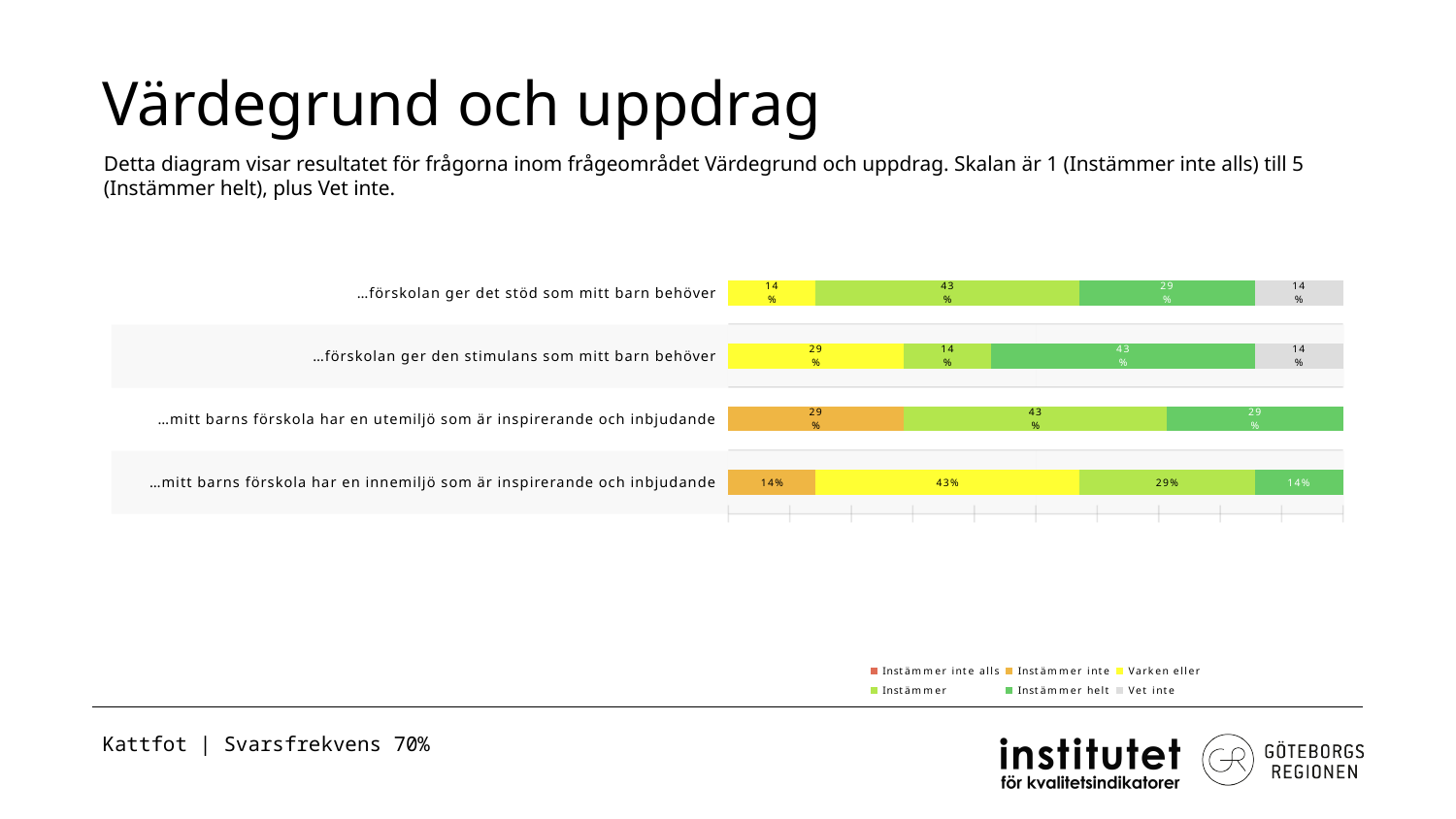
Which is larger for '…mitt barns förskola har en innemiljö som är inspirerande och inbjudande': the 'Instämmer inte' value or the 'Instämmer' value? Instämmer How many categories (statements) are plotted in the chart? 4 What is the 'Instämmer helt' value for '…förskolan ger den stimulans som mitt barn behöver'? 43% What is the 'Instämmer inte' value for '…mitt barns förskola har en utemiljö som är inspirerande och inbjudande'? 29% What kind of chart is shown on the slide? stacked bar chart How many series does the legend list? 6 What is the 'Varken eller' value for '…mitt barns förskola har en innemiljö som är inspirerande och inbjudande'? 43% What is the total of the segments in the bar for '…mitt barns förskola har en utemiljö som är inspirerande och inbjudande'? 101% What is the difference between the 'Instämmer helt' value and the 'Instämmer' value for '…förskolan ger den stimulans som mitt barn behöver'? 29% Which legend entry is shown in grey? Vet inte Which response category has the largest share for '…förskolan ger det stöd som mitt barn behöver'? Instämmer What is the 'Vet inte' value for '…förskolan ger det stöd som mitt barn behöver'? 14%